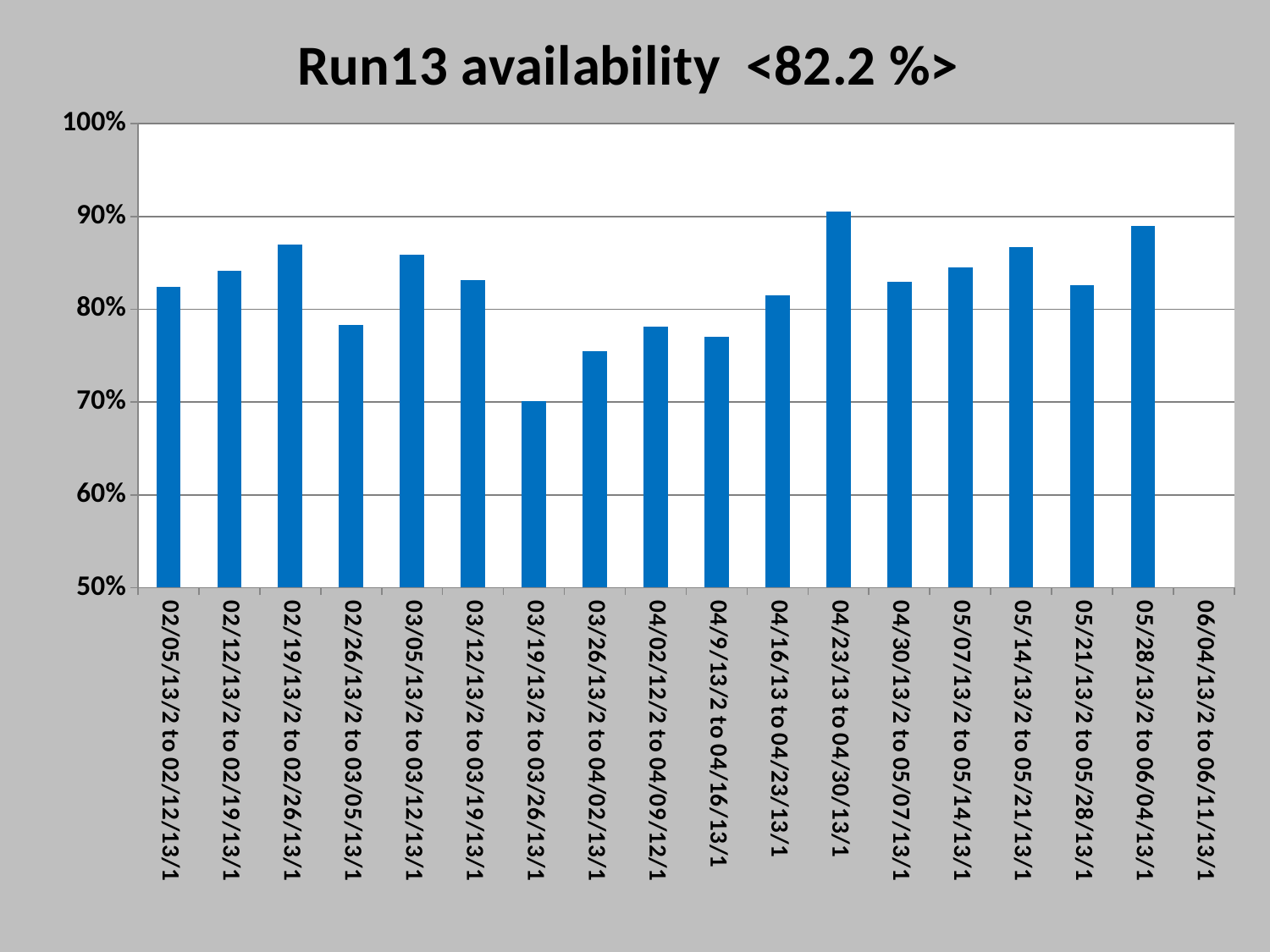
Is the value for 03/26/13/2 to 04/02/13/1 greater or less than 80%? less What kind of chart is shown on the slide? bar chart Which period has the highest availability? 04/23/13 to 04/30/13/1 Which period has the lowest availability? 03/19/13/2 to 03/26/13/1 Which is larger, the value for 02/19/13/2 to 02/26/13/1 or the value for 02/26/13/2 to 03/05/13/1? 02/19/13/2 to 02/26/13/1 What is the title of the chart? Run13 availability <82.2 %> Is the value for 02/19/13/2 to 02/26/13/1 greater or less than 80%? greater Is the value for 02/26/13/2 to 03/05/13/1 greater or less than 80%? less Which is larger, the value for 03/19/13/2 to 03/26/13/1 or the value for 04/23/13 to 04/30/13/1? 04/23/13 to 04/30/13/1 How many bars are plotted on the chart? 17 What colour are the bars in the chart? blue